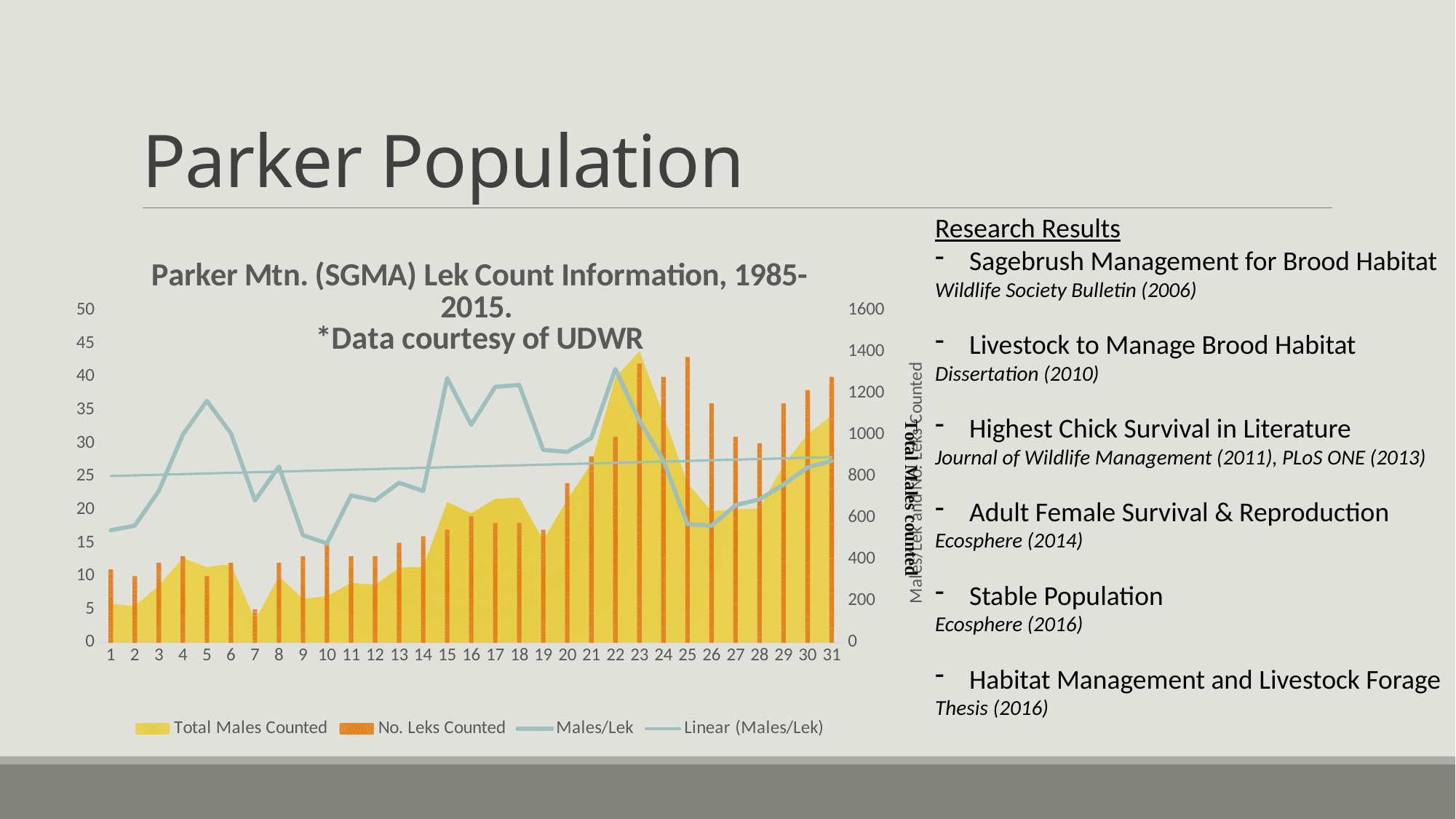
How many series does the chart legend list? 4 What is the title of the chart? Parker Mtn. (SGMA) Lek Count Information, 1985-2015. *Data courtesy of UDWR Is the Total Males Counted value at category 23 greater or less than 1000 on the right axis? greater At which x-axis category is the No. Leks Counted bar the lowest? 7 What is the maximum value shown on the right-hand vertical axis? 1600 What kind of chart is shown on the slide? Combination chart with an area series, a bar series and line series At which x-axis category does the Total Males Counted area reach its highest value? 23 Which is larger, the No. Leks Counted bar at category 7 or at category 23? Category 23 How many categories are shown along the x axis of the chart? 31 Does the Linear (Males/Lek) trendline rise or fall from left to right? Rises Is the Total Males Counted value at category 1 greater or less than 400 on the right axis? less Which series in the chart is drawn as bars? No. Leks Counted